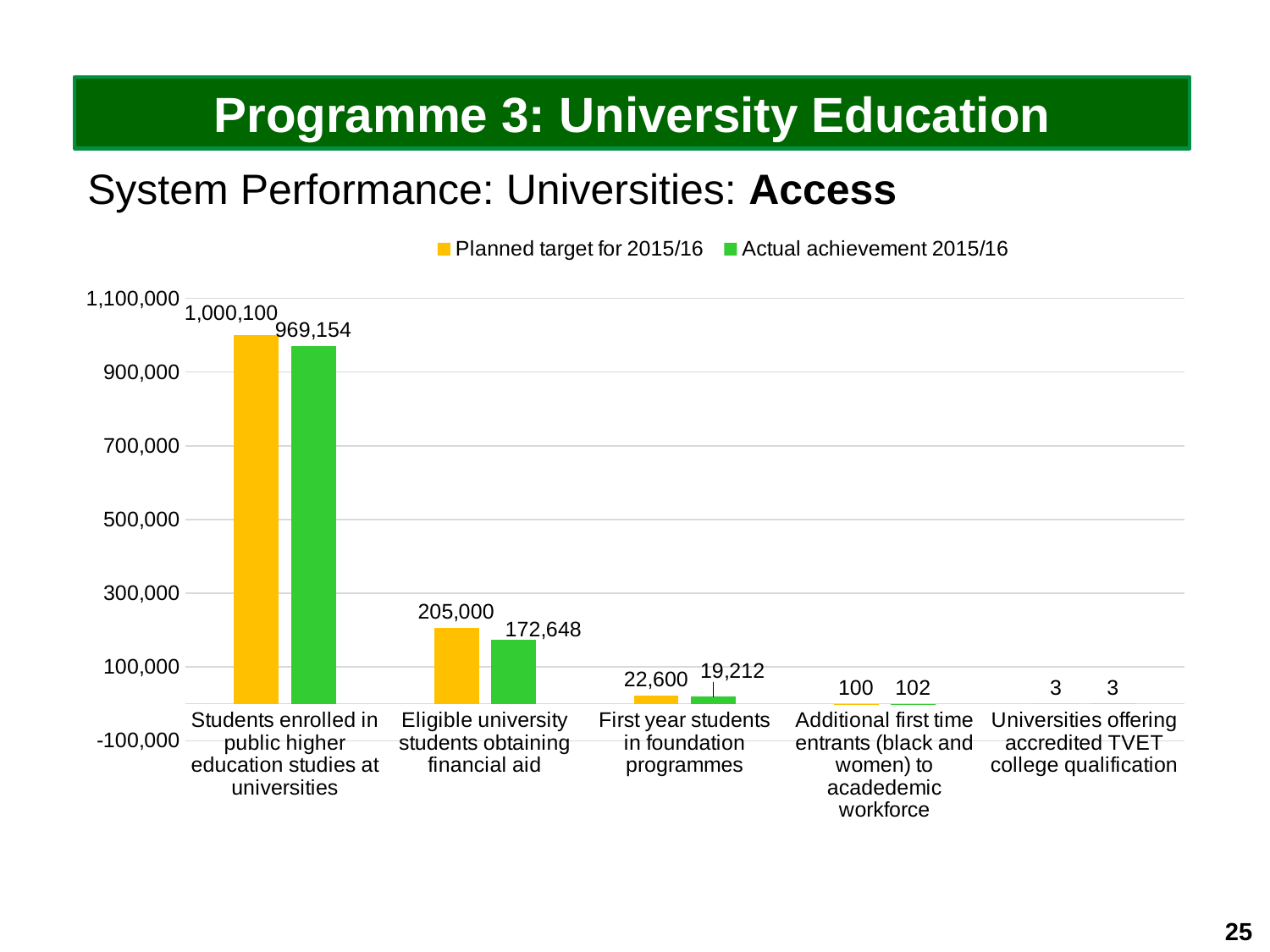
Which category has the highest planned target for 2015/16? Students enrolled in public higher education studies at universities What is the difference between the planned target and actual achievement for eligible university students obtaining financial aid? 32,352 What was the actual achievement in 2015/16 for eligible university students obtaining financial aid? 172,648 What was the planned target for 2015/16 for additional first time entrants (black and women) to academic workforce? 100 What was the actual achievement in 2015/16 for first year students in foundation programmes? 19,212 Which category has the lowest actual achievement in 2015/16? Universities offering accredited TVET college qualification What type of chart is shown on the slide? Bar chart For additional first time entrants (black and women) to academic workforce, which is larger: the planned target or the actual achievement? Actual achievement How many categories are shown on the x axis of the chart? 5 What is the difference between the planned target and actual achievement for students enrolled in public higher education studies at universities? 30,946 What was the planned target for 2015/16 for students enrolled in public higher education studies at universities? 1,000,100 How many series does the legend list? 2